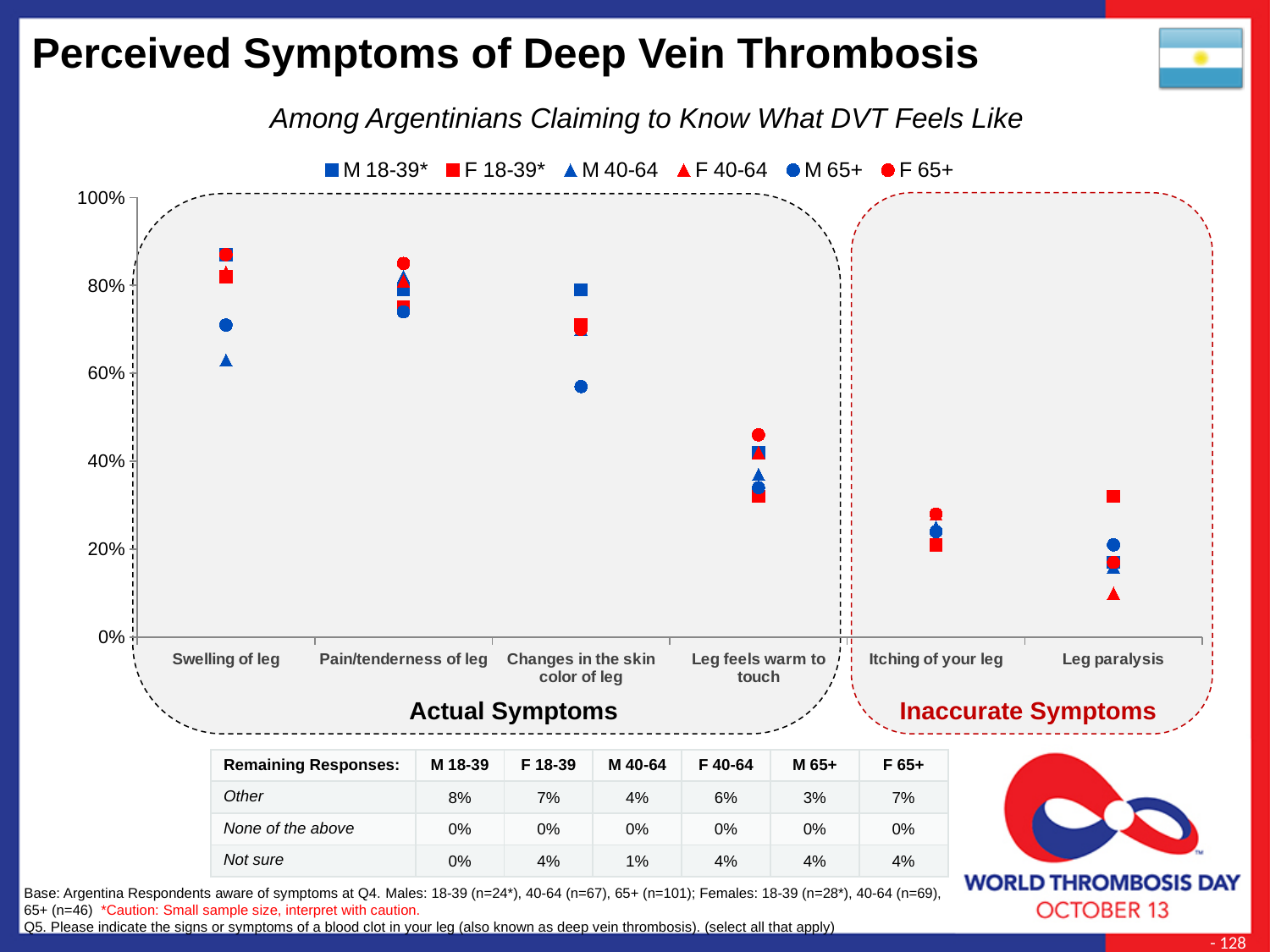
How many series does the legend list? 6 How many symptom categories are plotted along the x axis? 6 For F 40-64, which symptom category has the lowest value? Leg paralysis Which two categories are grouped under the label 'Inaccurate Symptoms'? Itching of your leg and Leg paralysis What kind of chart is shown on the slide? scatter (dot) chart For F 18-39*, which is larger: the value at Swelling of leg or the value at Leg paralysis? Swelling of leg In the Remaining Responses table, what is the 'Other' value for M 18-39? 8% Is the value for F 40-64 at Leg paralysis greater or less than 20%? less Is the value for F 65+ at Leg feels warm to touch greater or less than 40%? greater Is the value for M 65+ at Pain/tenderness of leg greater or less than 80%? less